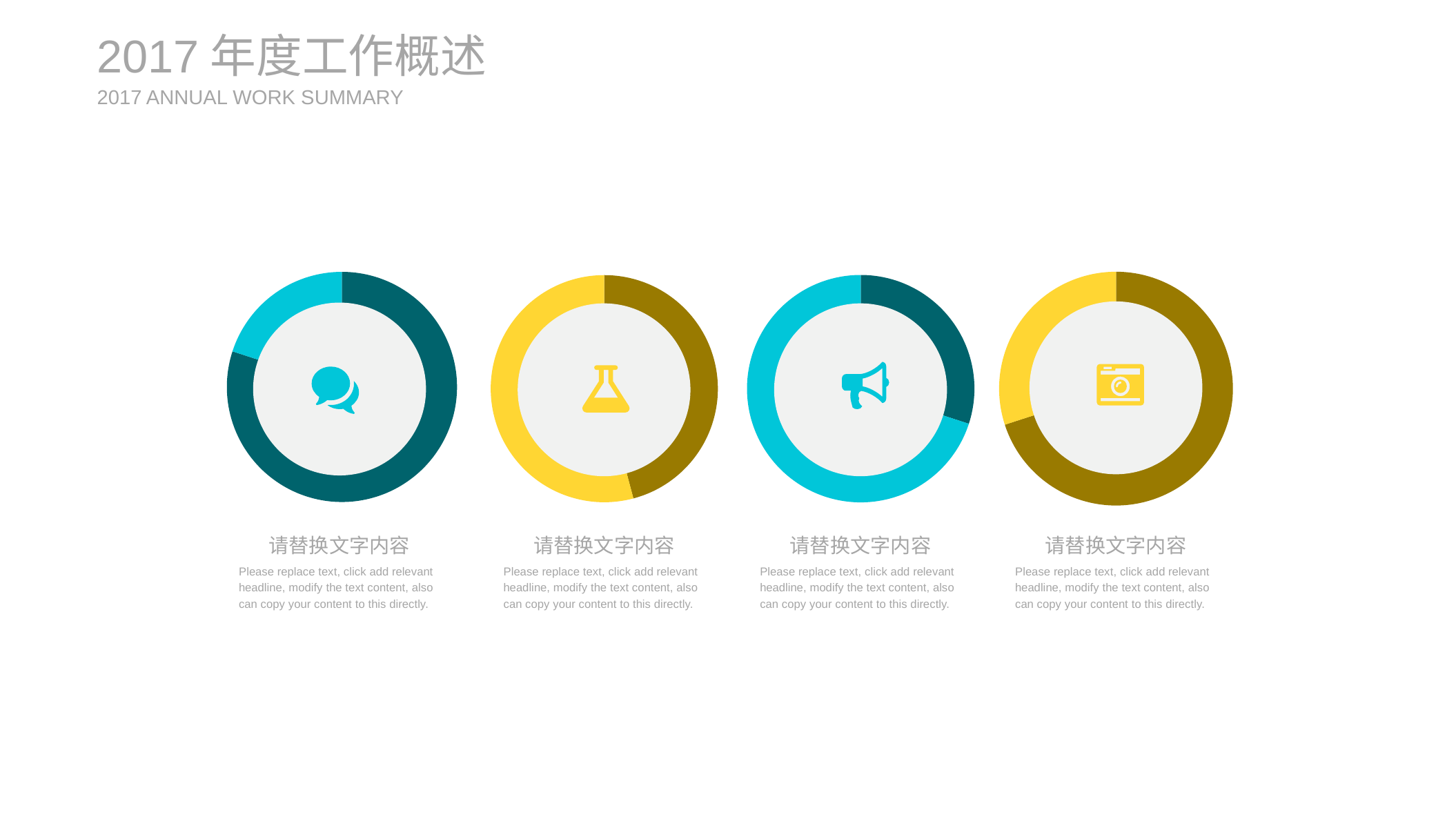
In the rightmost donut chart, is the olive segment greater or less than half of the ring? greater Which two colours are used in the second donut chart from the left? Yellow and olive What kind of chart is the rightmost chart on the slide? Donut chart How many segments does the leftmost donut chart have? 2 How many donut charts are shown on the slide? 4 In the rightmost donut chart, which segment is larger, the yellow one or the olive one? Olive How many segments does the second donut chart from the left have? 2 In the third donut chart from the left, which segment is larger, the light cyan one or the dark teal one? Light cyan In the leftmost donut chart, is the light cyan segment greater or less than half of the ring? less Do any of the donut charts on the slide show a legend? No What kind of chart is the leftmost chart on the slide? Donut chart In the leftmost donut chart, which segment is larger, the dark teal one or the light cyan one? Dark teal